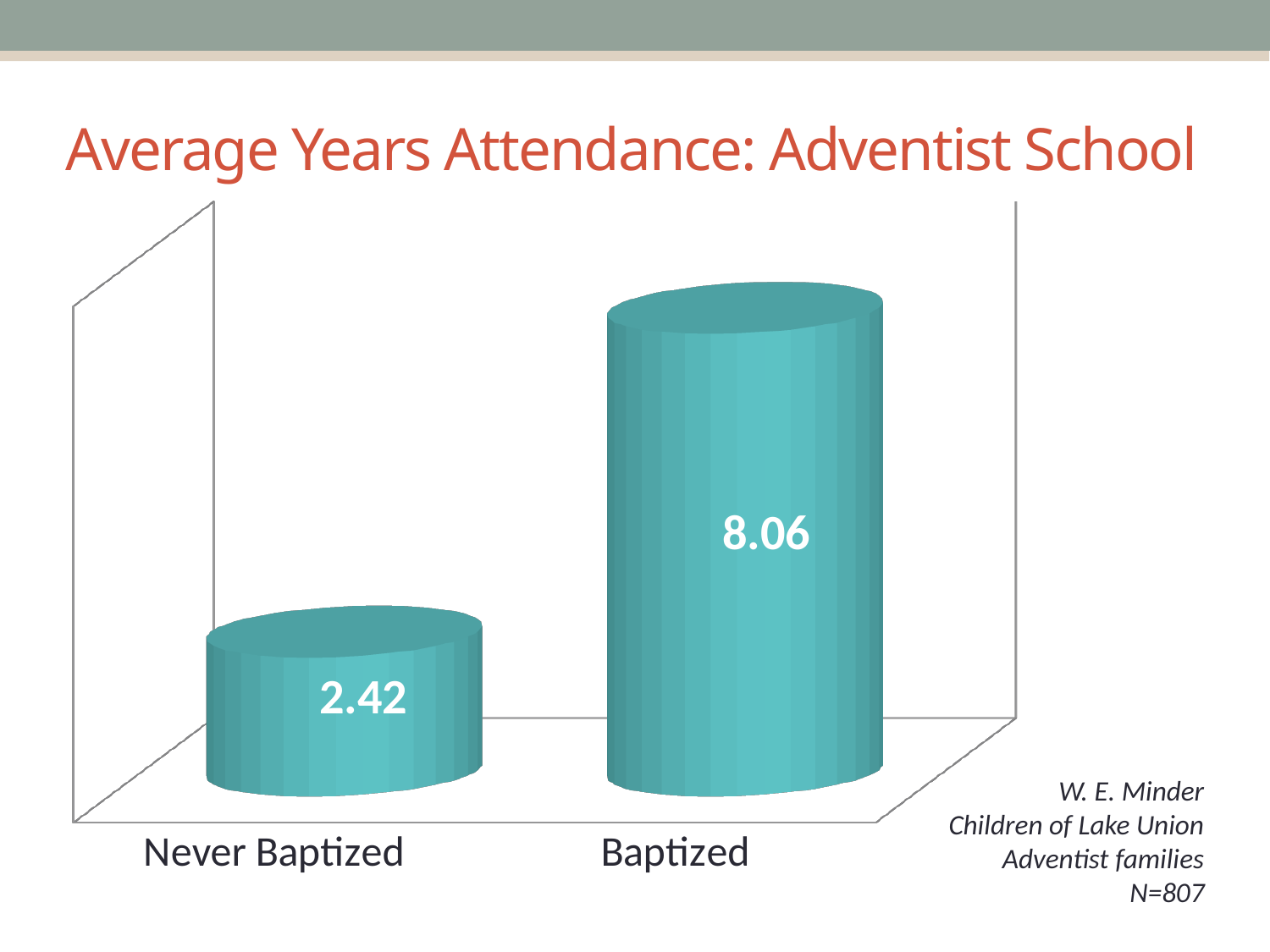
Which category has the highest average years of attendance? Baptized What is the average years of attendance for Never Baptized? 2.42 What is the difference in average years of attendance between Baptized and Never Baptized? 5.64 How many categories are shown in the chart? 2 What is the average years of attendance for Baptized? 8.06 What is the title of the chart? Average Years Attendance: Adventist School What is the sample size (N) noted on the slide? N=807 Which category has the lowest average years of attendance? Never Baptized Which is larger, the value for Baptized or the value for Never Baptized? Baptized What kind of chart is shown on the slide? Bar chart